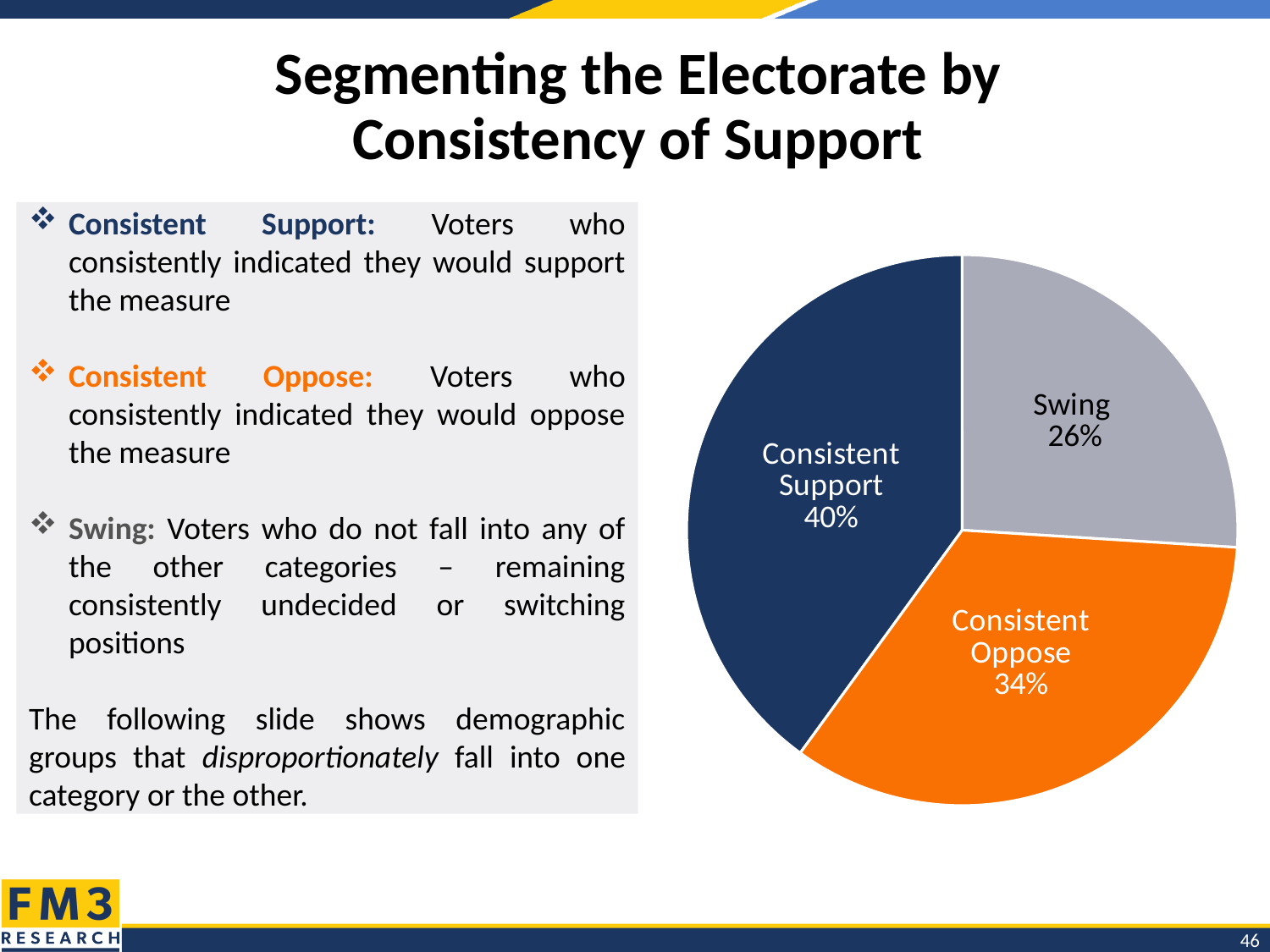
What colour is the Swing segment of the pie chart? Grey What type of chart is shown on the slide? Pie chart What share of the electorate is labelled Swing in the pie chart? 26% What is the difference in percentage points between the Consistent Support and Consistent Oppose segments? 6 What is the difference in percentage points between the Consistent Oppose and Swing segments? 8 How many segments does the pie chart have? 3 What share of the electorate is labelled Consistent Support in the pie chart? 40% What share of the electorate is labelled Consistent Oppose in the pie chart? 34% Which is larger, the Consistent Oppose segment or the Swing segment? Consistent Oppose Which segment of the pie chart is the smallest? Swing What colour is the Consistent Oppose segment of the pie chart? Orange Which segment of the pie chart is the largest? Consistent Support